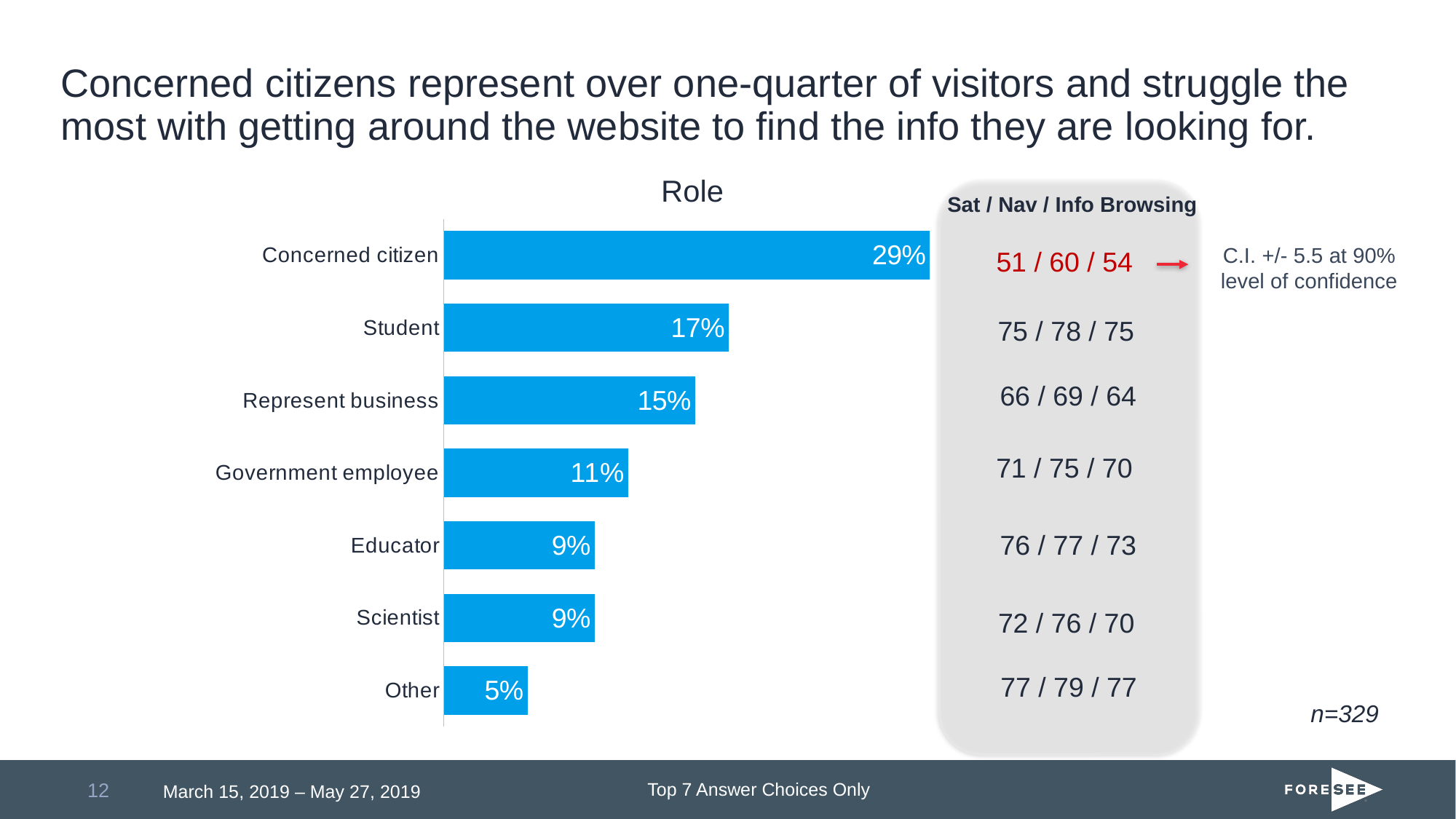
How many roles are shown in the Role chart? 7 What kind of chart is the Role chart? Bar chart What is the difference between the values for Concerned citizen and Student in the Role chart? 12% Which is larger in the Role chart, the value for Student or the value for Represent business? Student What is the value for Other in the Role chart? 5% What is the value for Student in the Role chart? 17% What is the value for Government employee in the Role chart? 11% What is the value for Concerned citizen in the Role chart? 29% What is the difference between the values for Represent business and Government employee in the Role chart? 4% Which role has the lowest value in the Role chart? Other Which role has the highest value in the Role chart? Concerned citizen What is the title of the chart on the slide? Role